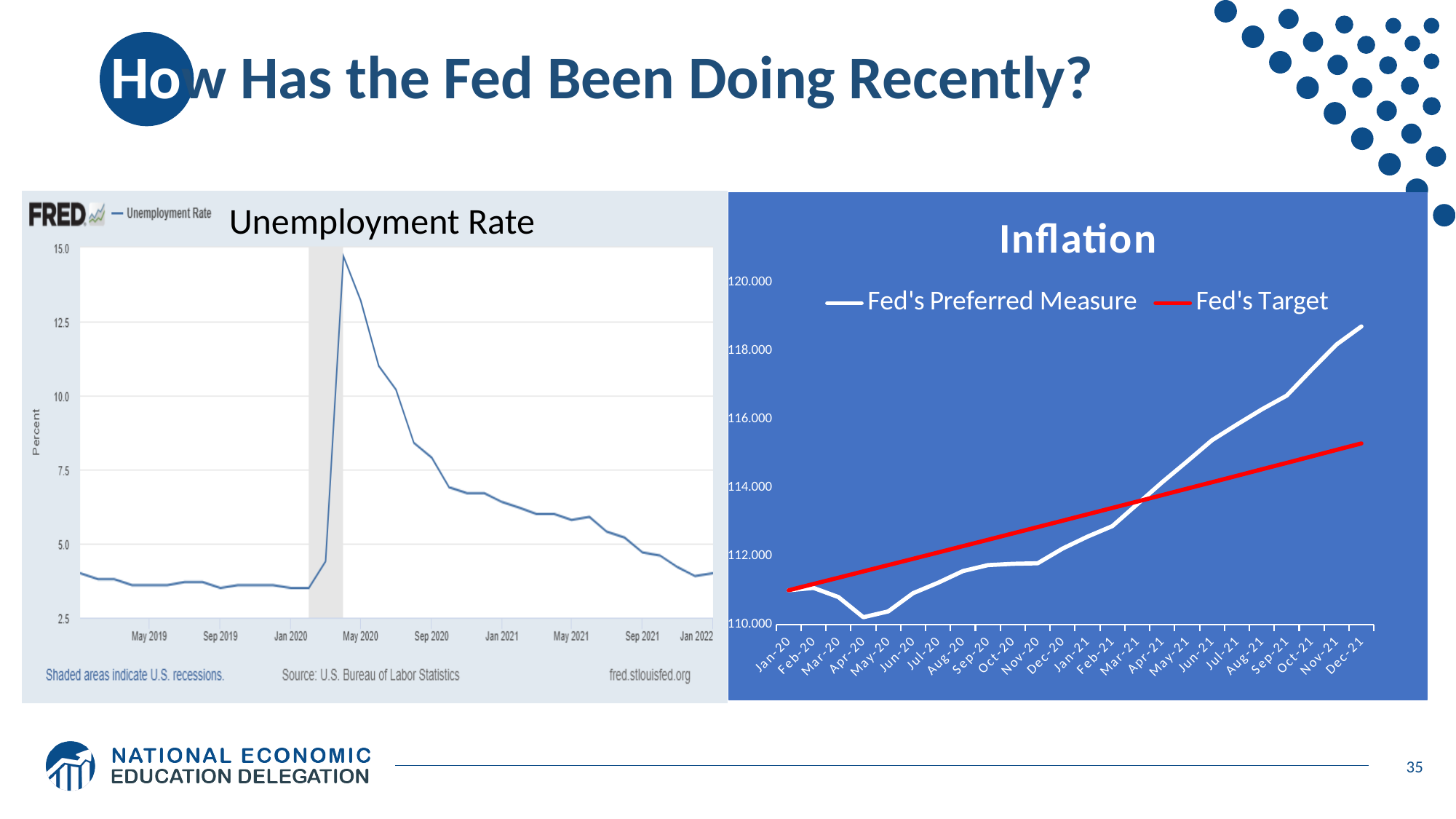
In the Inflation chart, is the value of Fed's Target in Dec-21 greater or less than 116.000? less In the Unemployment Rate chart, is the peak value in 2020 greater or less than 12.5 percent? greater In the Inflation chart, which series is higher in Apr-20, Fed's Preferred Measure or Fed's Target? Fed's Target In the Inflation chart, which series is higher in Dec-21, Fed's Preferred Measure or Fed's Target? Fed's Preferred Measure In the Unemployment Rate chart, does the unemployment rate rise or fall from May 2020 to Jan 2022? fall What are the two series named in the legend of the Inflation chart? Fed's Preferred Measure and Fed's Target In the Inflation chart, is the value of Fed's Preferred Measure in Dec-21 greater or less than 118.000? greater What kind of chart is the Unemployment Rate chart? line chart How many monthly points are plotted along the x axis of the Inflation chart? 24 In the Inflation chart, does Fed's Target rise or fall from Jan-20 to Dec-21? rise How many series does the legend of the Inflation chart list? 2 What kind of chart is the Inflation chart? line chart